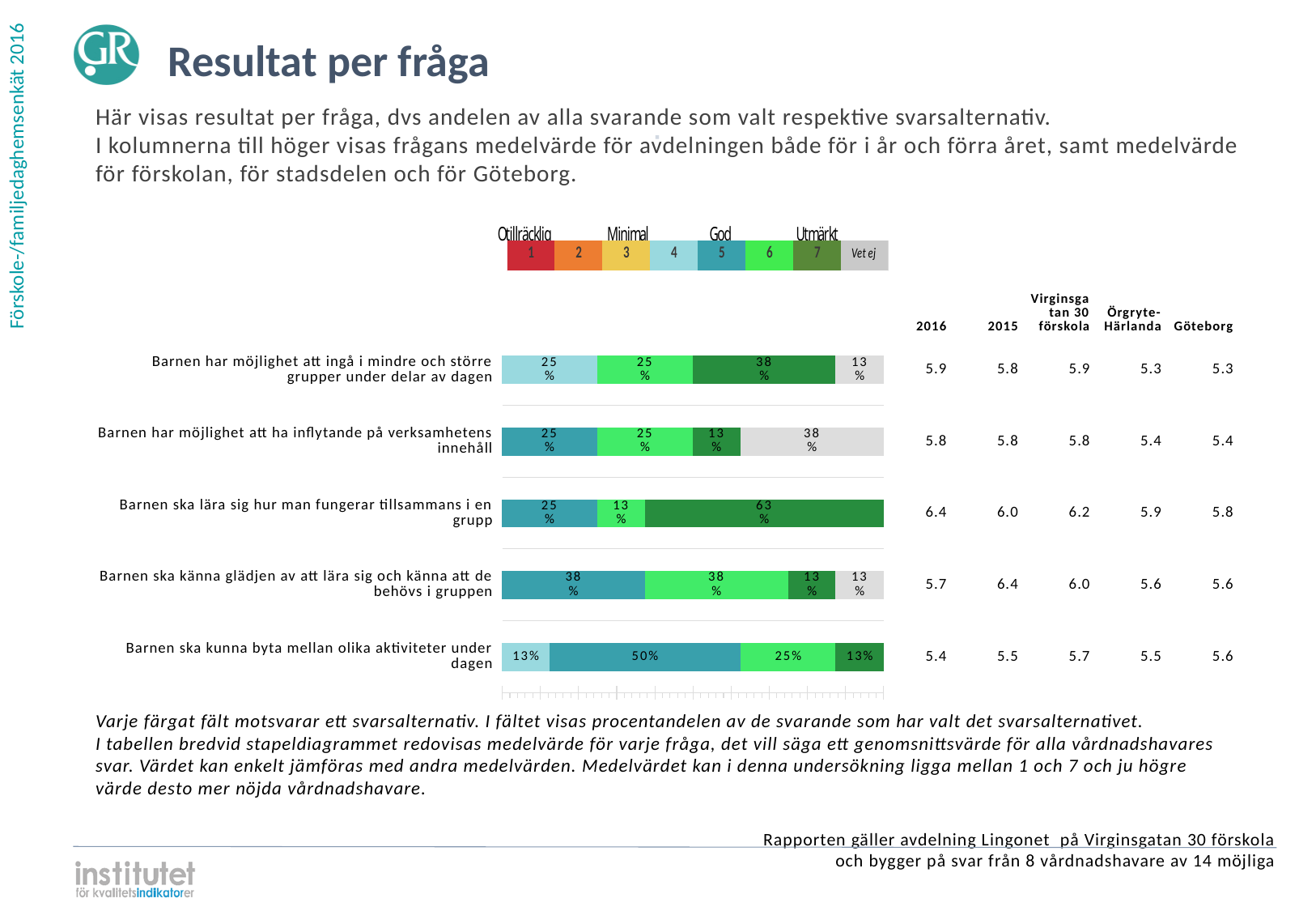
What percentage chose answer 7 (dark green) for 'Barnen ska lära sig hur man fungerar tillsammans i en grupp'? 63% Which question has the lowest 2016 mean value in the table? Barnen ska kunna byta mellan olika aktiviteter under dagen What is the difference between the 2016 and 2015 mean values for 'Barnen ska lära sig hur man fungerar tillsammans i en grupp'? 0.4 How many answer alternatives does the legend above the chart list? 8 What is the largest segment in the bar for 'Barnen ska kunna byta mellan olika aktiviteter under dagen'? 50% For 'Barnen ska känna glädjen av att lära sig och känna att de behövs i gruppen', is the 2016 mean or the 2015 mean higher? 2015 What is the Göteborg mean value for 'Barnen har möjlighet att ingå i mindre och större grupper under delar av dagen'? 5.3 How many questions (bars) are shown in the chart? 5 What is the 2015 mean value for 'Barnen ska känna glädjen av att lära sig och känna att de behövs i gruppen'? 6.4 What kind of chart is used to show the results per question on this slide? Stacked bar chart What percentage of respondents chose 'Vet ej' for 'Barnen har möjlighet att ha inflytande på verksamhetens innehåll'? 38% Which question has the highest 2016 mean value in the table? Barnen ska lära sig hur man fungerar tillsammans i en grupp